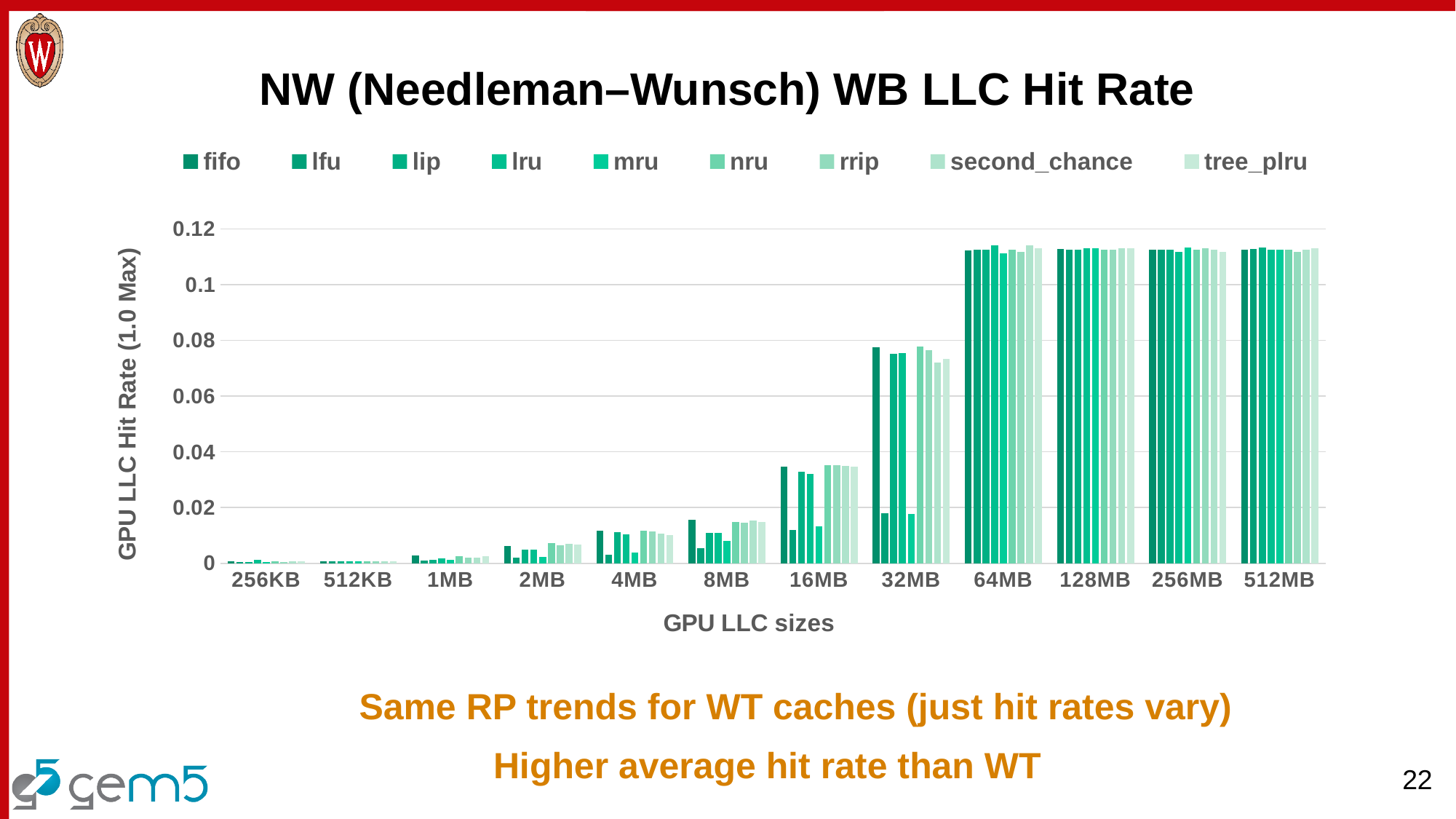
Is the fifo hit rate at 64MB greater or less than 0.1? greater At 32MB, which is larger: the fifo hit rate or the lfu hit rate? fifo Do the hit rates generally rise or fall as the GPU LLC size increases along the x axis? rise Is the lfu hit rate at 32MB greater or less than 0.04? less What is the title of the chart? NW (Needleman–Wunsch) WB LLC Hit Rate Is the fifo hit rate at 32MB greater or less than 0.06? greater What kind of chart is shown on the slide? bar chart What is the label of the y axis? GPU LLC Hit Rate (1.0 Max) How many GPU LLC sizes are shown along the x axis? 12 How many series does the legend list? 9